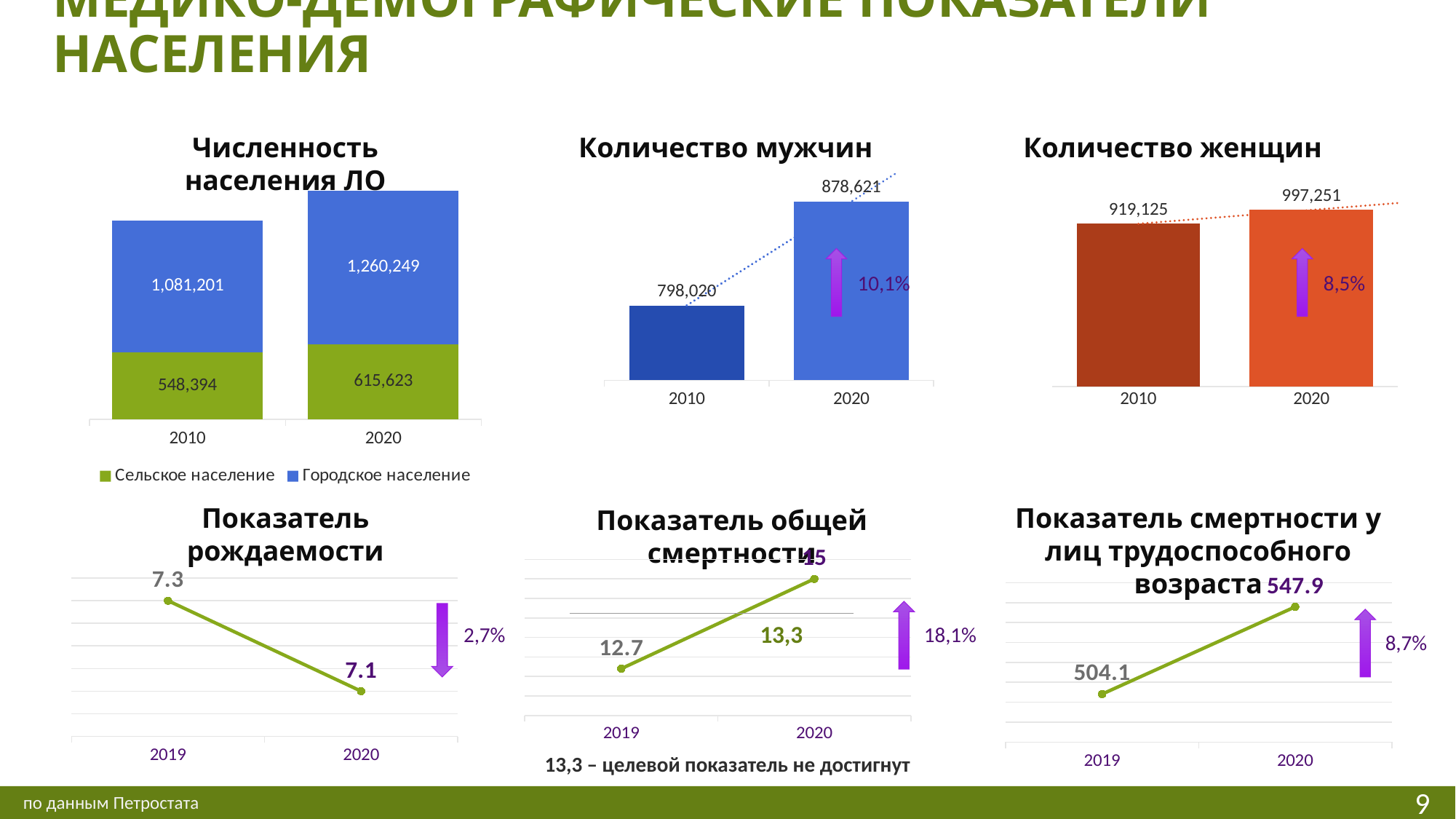
In the chart 'Численность населения ЛО', what is the total of the stacked bar for 2020? 1,875,872 What kind of chart is 'Количество женщин'? bar chart In the chart 'Численность населения ЛО', what is the value for Городское население in 2010? 1,081,201 In the chart 'Численность населения ЛО', what is the value for Сельское население in 2020? 615,623 In the chart 'Количество мужчин', what is the difference between the 2020 and 2010 values? 80,601 In the chart 'Количество мужчин', what is the value for 2010? 798,020 In the chart 'Показатель смертности у лиц трудоспособного возраста', what is the difference between the 2020 and 2019 values? 43.8 In the chart 'Показатель рождаемости', does the value rise or fall from 2019 to 2020? fall In the chart 'Количество женщин', what is the value for 2020? 997,251 In the chart 'Показатель смертности у лиц трудоспособного возраста', which year has the higher value, 2019 or 2020? 2020 In the chart 'Показатель общей смертности', what is the value for 2019? 12.7 How many series does the legend of the chart 'Численность населения ЛО' list? 2